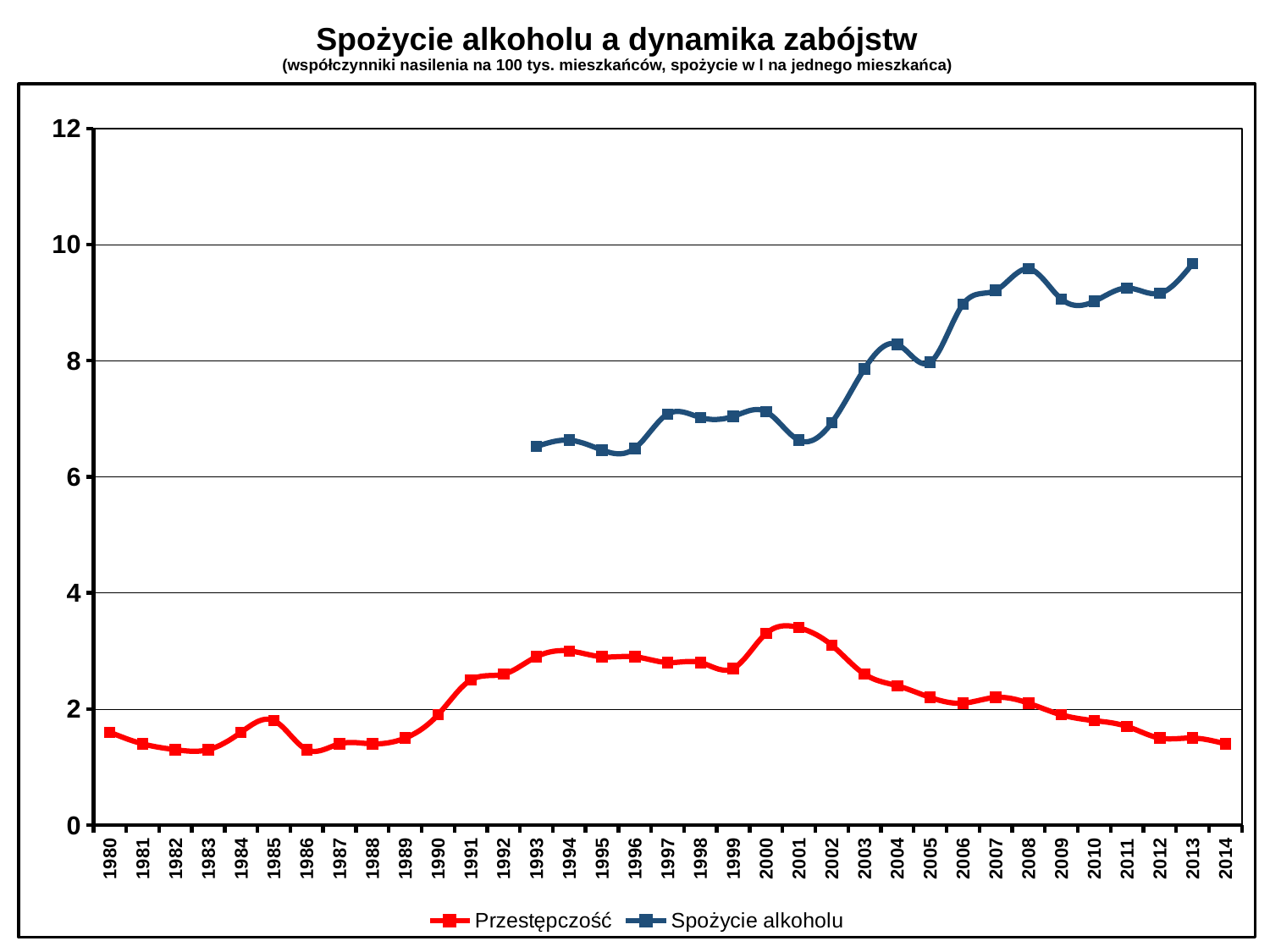
Is the value for Przestępczość in 2001 greater or less than 4? less Does the Przestępczość series rise or fall from 2001 to 2014? fall Is the value for Spożycie alkoholu in 1993 greater or less than 6? greater How many series does the legend list? 2 What kind of chart is shown on the slide? line chart Which is larger for Przestępczość: the value in 2001 or the value in 2014? 2001 Is the value for Spożycie alkoholu in 2008 greater or less than 8? greater What is the title of the chart? Spożycie alkoholu a dynamika zabójstw How many years are shown on the x axis? 35 Which is larger for Spożycie alkoholu: the value in 2008 or the value in 2001? 2008